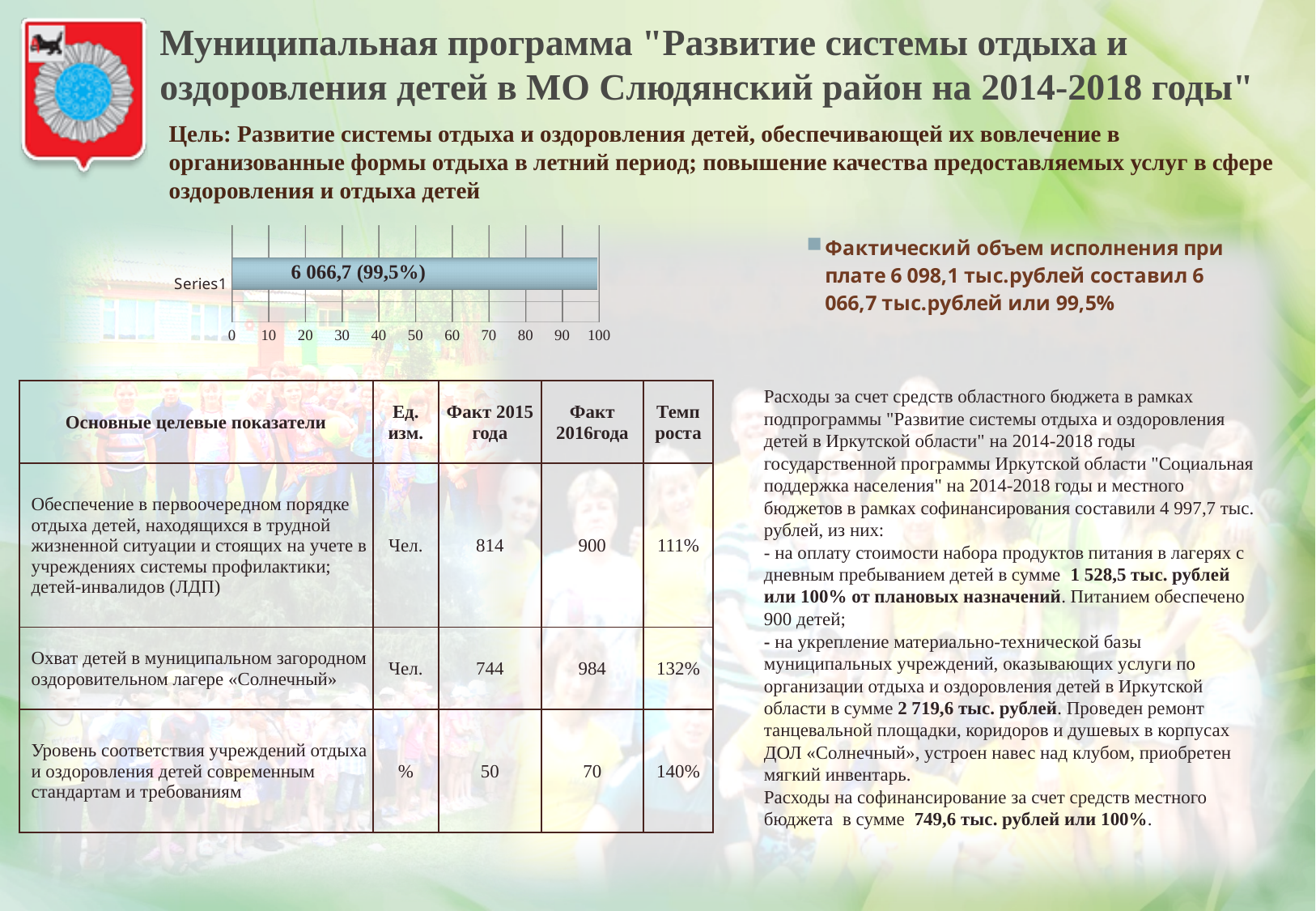
Is the bar for Series1 greater or less than 50 on the axis? greater What is the highest value shown on the chart's horizontal axis? 100 How many bars does the chart contain? 1 Is the bar for Series1 greater or less than 90 on the axis? greater What is the category label shown next to the bar in the chart? Series1 What is the data label printed on the bar in the chart? 6 066,7 (99,5%) What percentage is shown in parentheses in the bar's data label? 99,5% What kind of chart is shown on the slide? bar chart